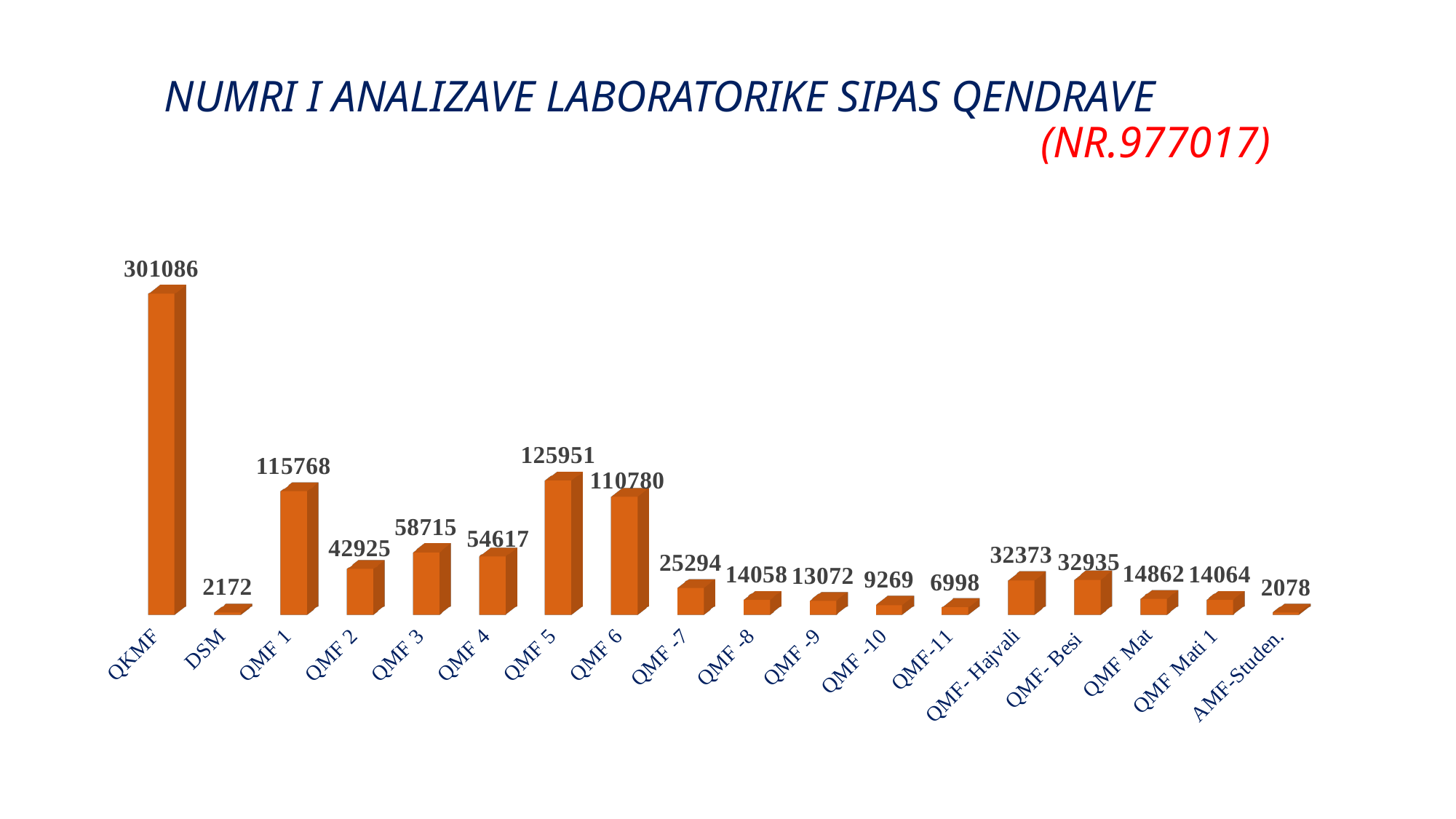
What kind of chart is shown on the slide? Bar chart What is the value for QMF- Hajvali? 32373 What is the difference between the values for QMF 5 and QMF 6? 15171 What is the difference between the values for QKMF and QMF 1? 185318 What is the value for QKMF? 301086 How many categories are shown in the chart? 18 Which category has the lowest value? AMF-Studen. Which has a larger value, QMF 3 or QMF 4? QMF 3 What is the value for DSM? 2172 Which category has the highest value? QKMF What is the value for QMF 5? 125951 What total number is shown in red in the title area? NR.977017